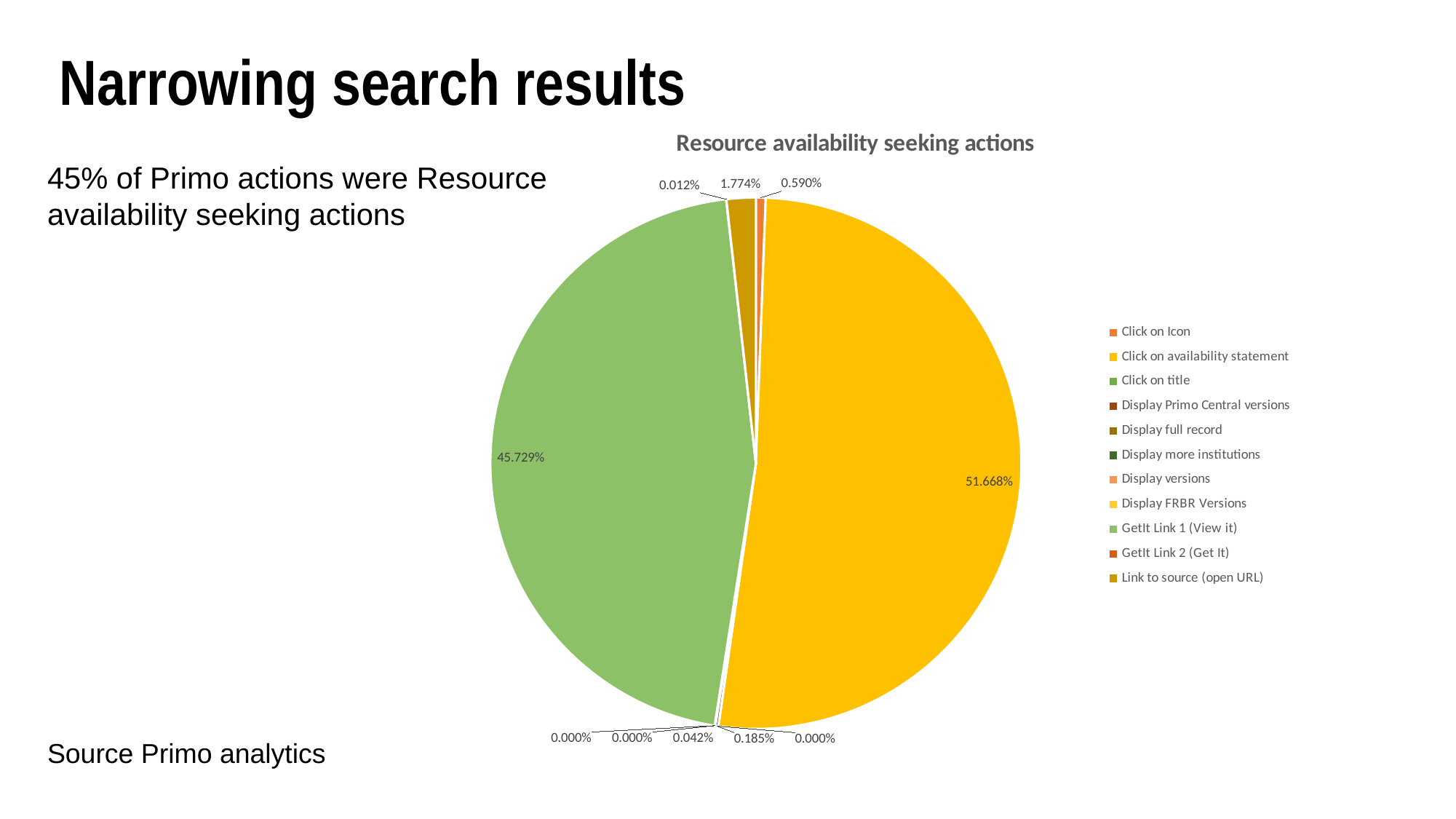
What is the percentage shown on the largest slice of the pie? 51.668% What is the combined share of the two largest slices (51.668% and 45.729%)? 97.397% How many entries does the chart legend list? 11 Which is larger, the yellow slice or the green slice? the yellow slice What is the largest percentage shown among the small slices at the top of the pie? 1.774% Is the largest slice greater or less than 50%? greater What is the percentage shown on the second-largest (green) slice of the pie? 45.729% What is the title of the chart? Resource availability seeking actions What type of chart is shown on the slide? pie chart What is the difference between the two largest slices, 51.668% and 45.729%? 5.939% What is the smallest non-zero percentage labelled on the pie? 0.012%